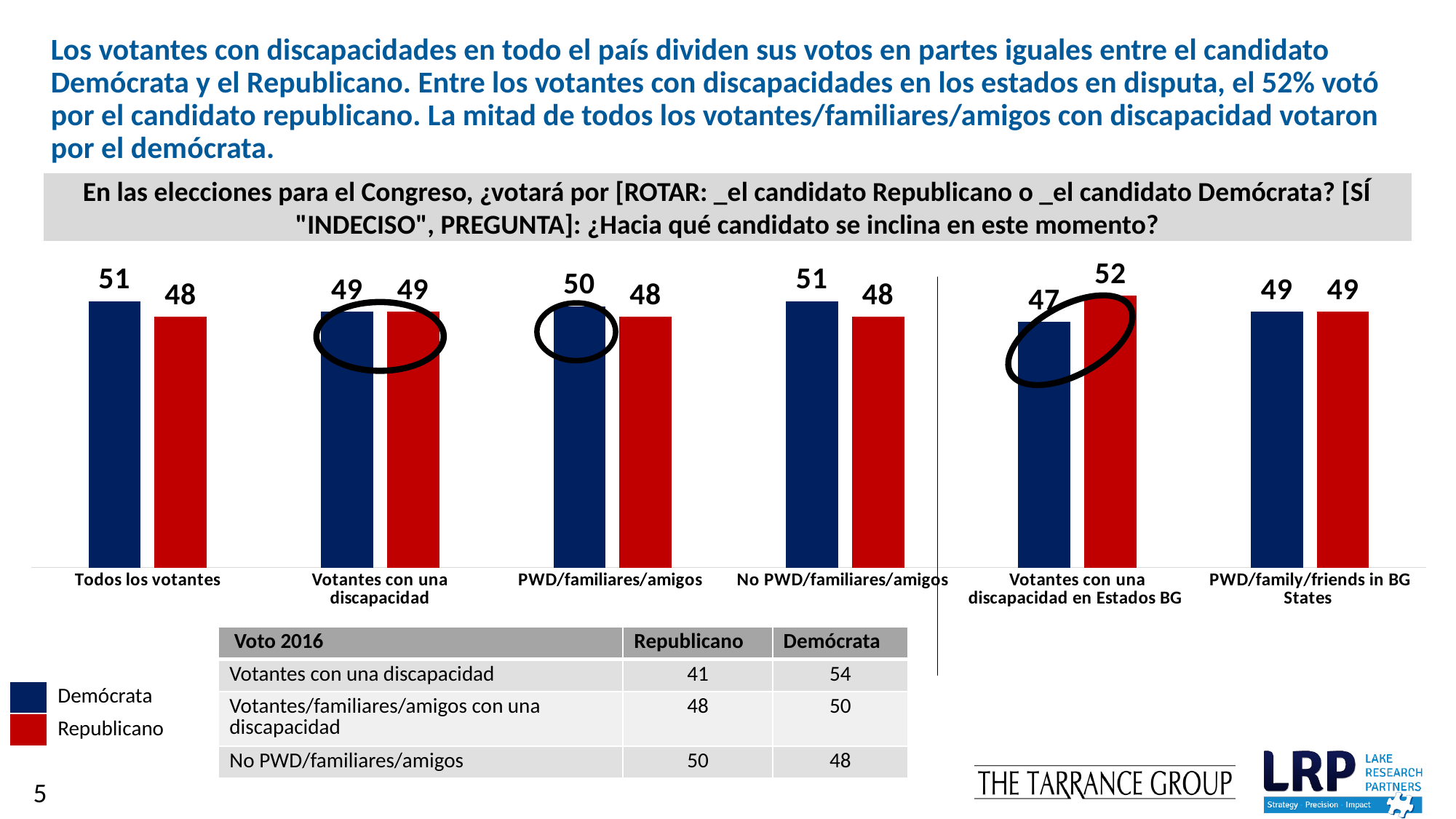
What is the Demócrata value for PWD/familiares/amigos? 50 Which colour represents Republicano in the chart? Red What kind of chart is shown on the slide? Bar chart How many categories are shown on the x axis of the chart? 6 Which category has the highest Republicano value? Votantes con una discapacidad en Estados BG How many series does the legend list? 2 Which category has the lowest Demócrata value? Votantes con una discapacidad en Estados BG What is the difference between the Demócrata and Republicano values for Todos los votantes? 3 What is the Demócrata value for Todos los votantes? 51 For Votantes con una discapacidad en Estados BG, which is larger, the Demócrata or the Republicano value? Republicano What is the Republicano value for No PWD/familiares/amigos? 48 What is the Republicano value for Votantes con una discapacidad en Estados BG? 52